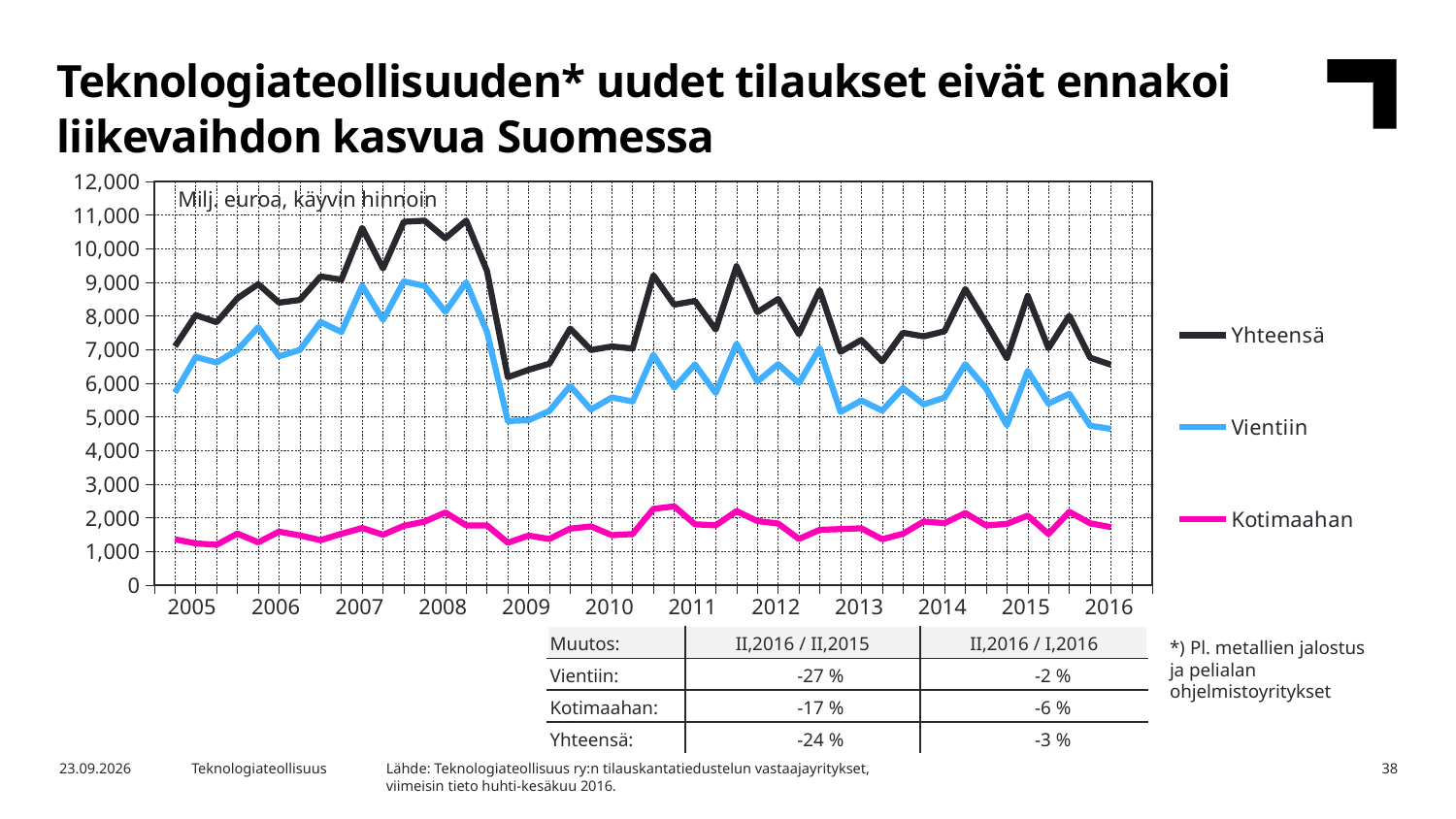
Is the last plotted value for Vientiin in 2016 greater or less than 5,000? less Which series has the highest values across the whole chart? Yhteensä Which series has the lowest values across the whole chart? Kotimaahan How many years are labelled on the x axis of the chart? 12 Does the Yhteensä series rise or fall from 2015 to 2016? fall Is the lowest value of Yhteensä in 2009 greater or less than 7,000? less What type of chart is shown on the slide? line chart What are the three series named in the chart's legend? Yhteensä, Vientiin, Kotimaahan Is the value for Kotimaahan in 2016 greater or less than 3,000? less How many series does the chart's legend list? 3 What unit label is printed inside the chart's plot area? Milj. euroa, käyvin hinnoin